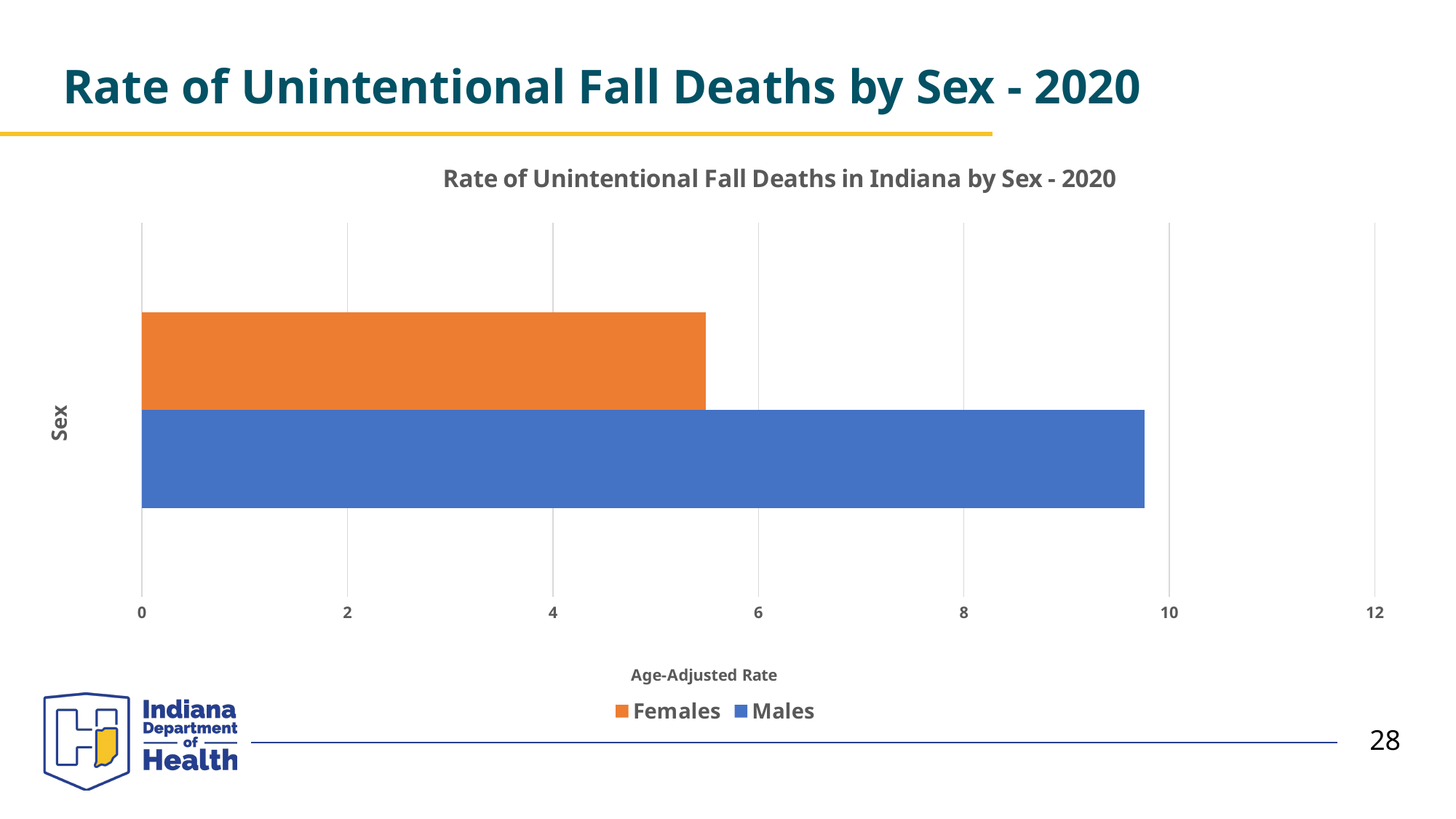
What is the title of the chart? Rate of Unintentional Fall Deaths in Indiana by Sex - 2020 What is the label of the horizontal axis? Age-Adjusted Rate Is the value for Males greater or less than 10? less Is the value for Males greater or less than 8? greater Which series has the highest age-adjusted rate? Males Is the value for Females greater or less than 4? greater How many series does the legend list? 2 What kind of chart is shown on the slide? bar chart Which series has the lowest age-adjusted rate? Females Which series has the higher age-adjusted rate, Females or Males? Males